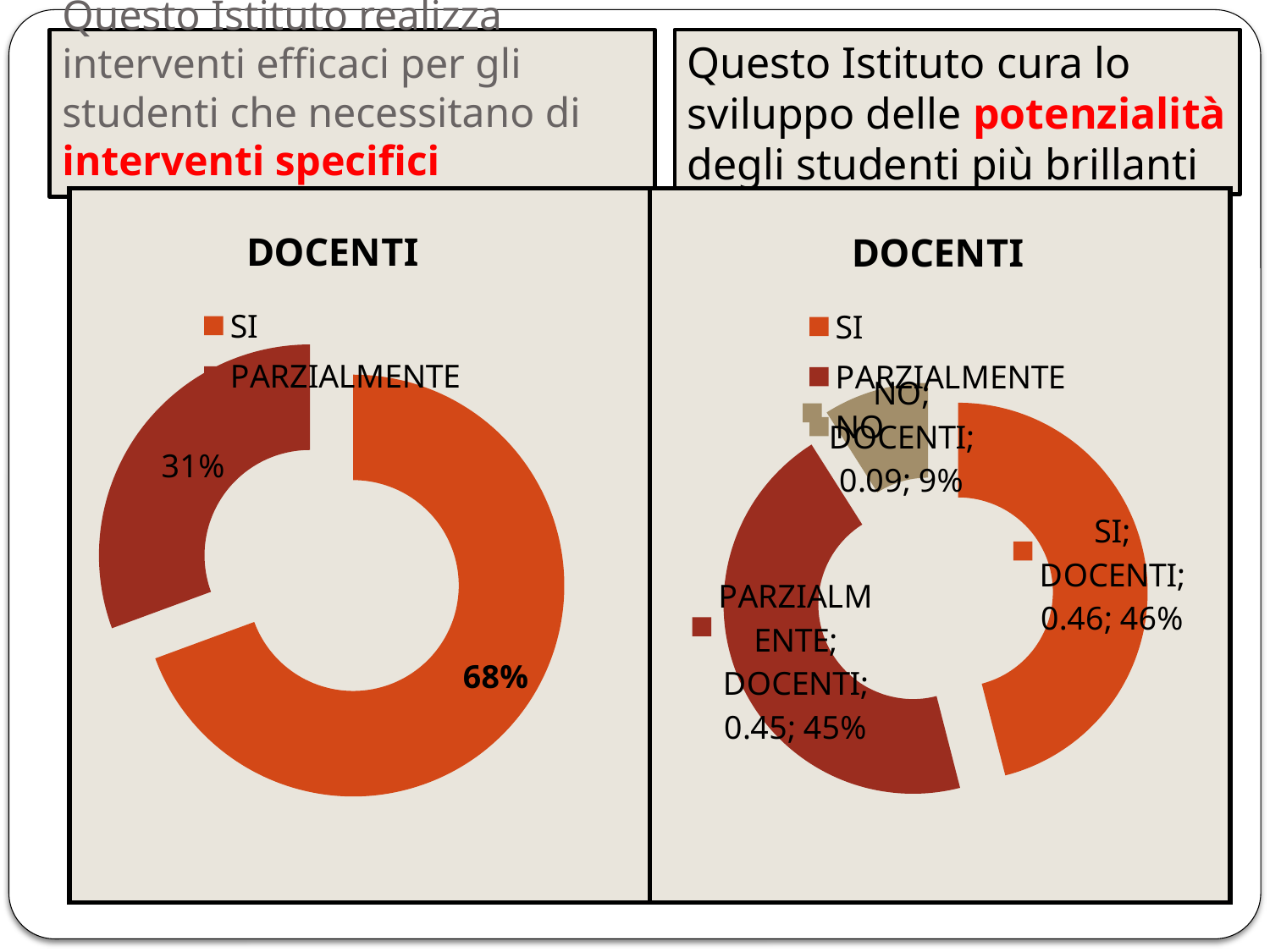
What type of chart is used on the left side of the slide? Doughnut (pie) chart In the right chart (under 'potenzialità'), what percentage of DOCENTI answered NO? 9% In the right chart (under 'potenzialità'), how many slices does the chart have? 3 In the right chart (under 'potenzialità'), what is the difference in percentage points between PARZIALMENTE and NO? 36 In the left chart (under 'interventi specifici'), what percentage of DOCENTI answered SI? 68% In the left chart (under 'interventi specifici'), which response has the largest share? SI In the left chart (under 'interventi specifici'), what is the difference in percentage points between SI and PARZIALMENTE? 37 What is the title of the right chart (under 'potenzialità')? DOCENTI In the right chart (under 'potenzialità'), what percentage of DOCENTI answered PARZIALMENTE? 45% In the left chart (under 'interventi specifici'), what percentage of DOCENTI answered PARZIALMENTE? 31% In the right chart (under 'potenzialità'), what percentage of DOCENTI answered SI? 46% In the right chart (under 'potenzialità'), which response has the smallest share? NO